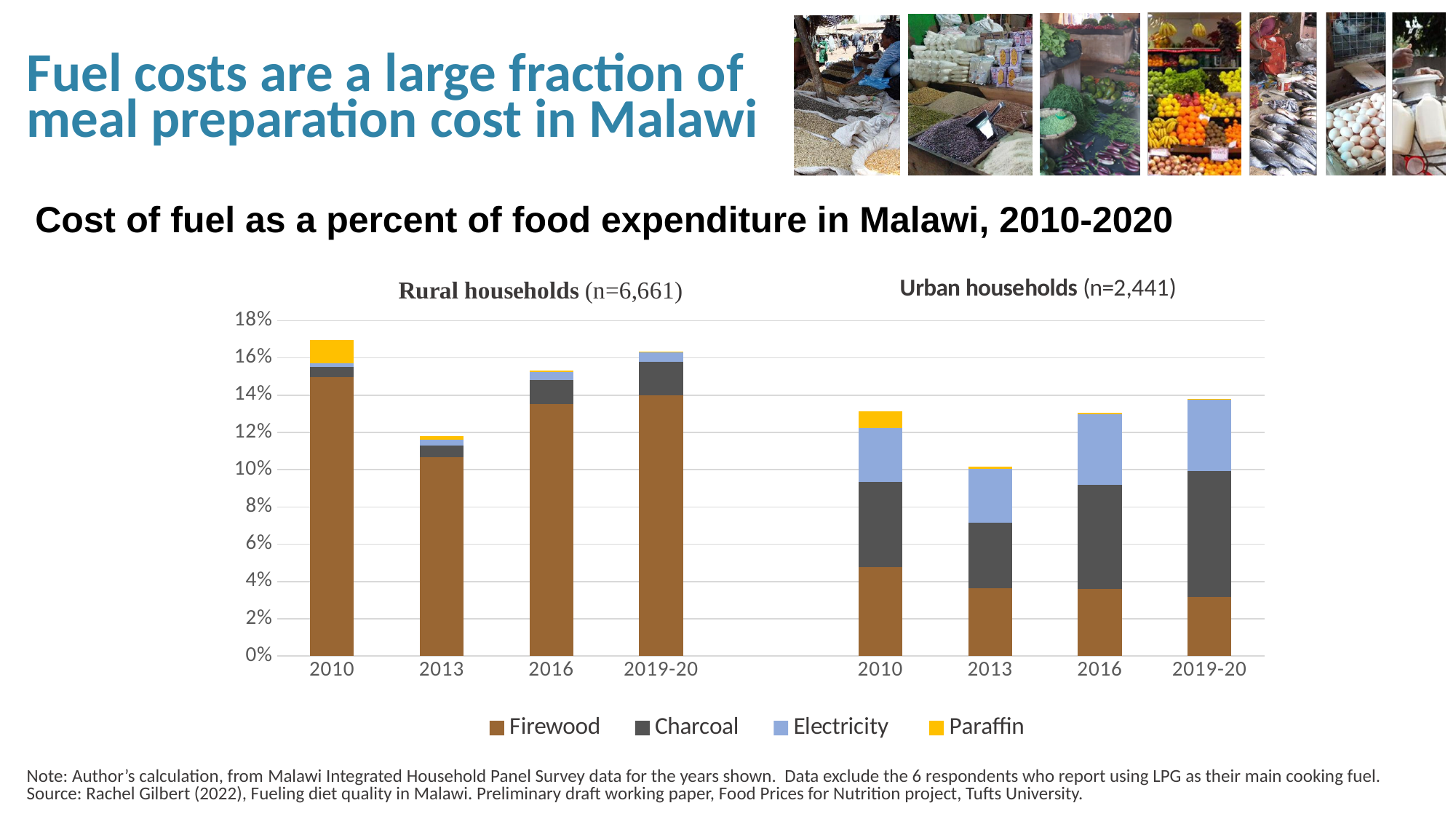
In the Urban households chart, which period has the lowest total fuel cost as a percent of food expenditure? 2013 In the Rural households chart, how many survey periods are shown on the x axis? 4 In the Urban households chart, is the total for 2013 greater or less than 12%? less What kind of chart is shown on the slide? Stacked bar chart In the Rural households chart, which period has the lowest total fuel cost as a percent of food expenditure? 2013 In the Rural households chart, is the total for 2010 greater or less than 16%? greater In the Rural households chart, which period has the highest total fuel cost as a percent of food expenditure? 2010 Which colour represents Paraffin in the legend? Yellow How many series does the legend list? 4 Which is larger for 2010: the total fuel cost share for Rural households or for Urban households? Rural households In the Urban households chart, does the Electricity share rise or fall from 2013 to 2019-20? rise In the Urban households chart, is the total for 2019-20 greater or less than 12%? greater